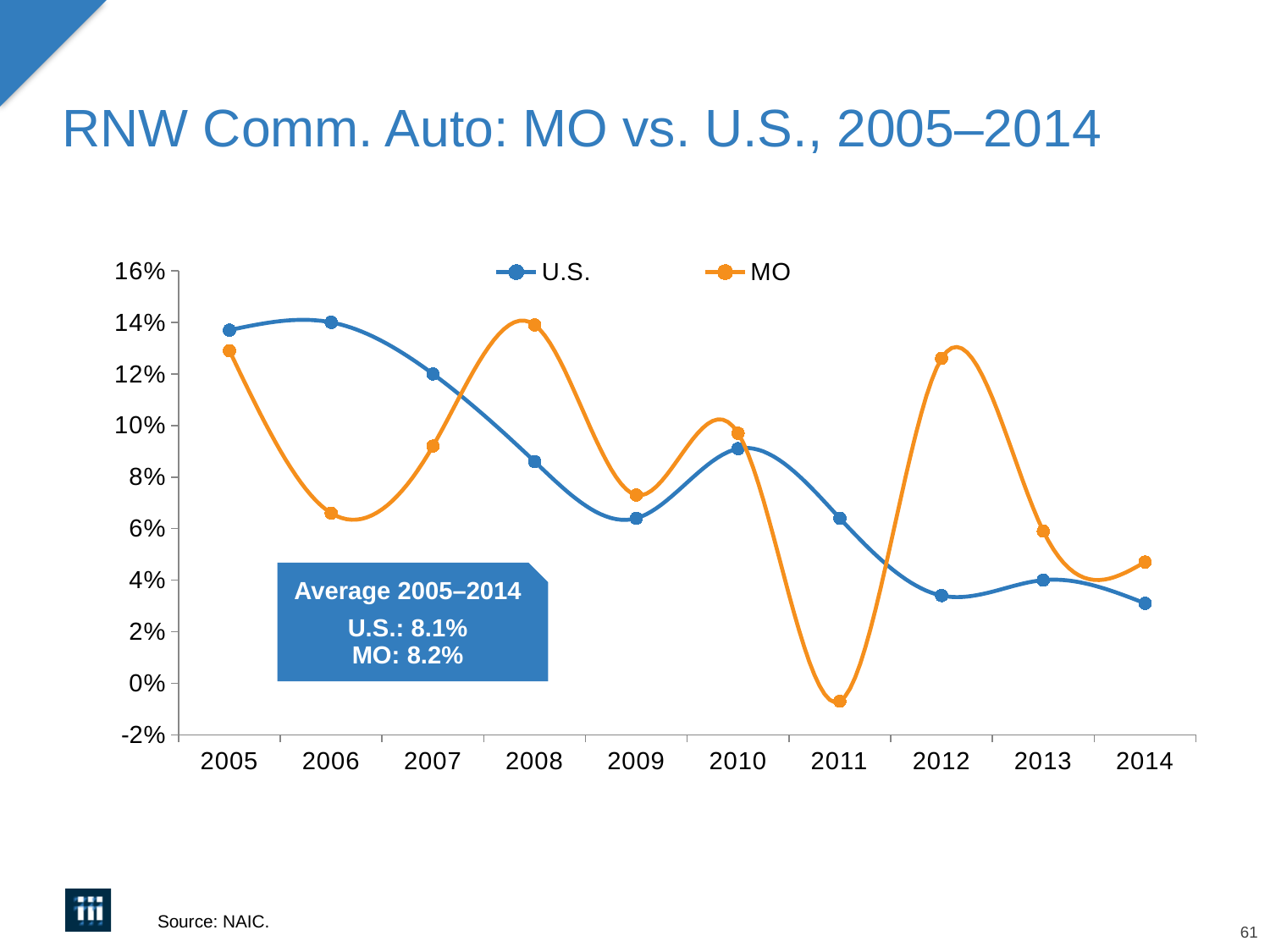
Is the U.S. value for 2014 greater or less than 4%? less Does the U.S. series rise or fall from 2006 to 2009? fall What kind of chart is shown on the slide? line chart In which year is the MO value highest? 2008 In 2011, which series has the larger value, U.S. or MO? U.S. What is the average RNW for MO over 2005–2014, as shown in the text box? 8.2% How many years are plotted along the x axis? 10 In which year is the MO value lowest? 2011 What is the average RNW for the U.S. over 2005–2014, as shown in the text box? 8.1% Is the MO value for 2011 greater or less than 0%? less How many series does the legend list? 2 Is the U.S. value for 2005 greater or less than 12%? greater